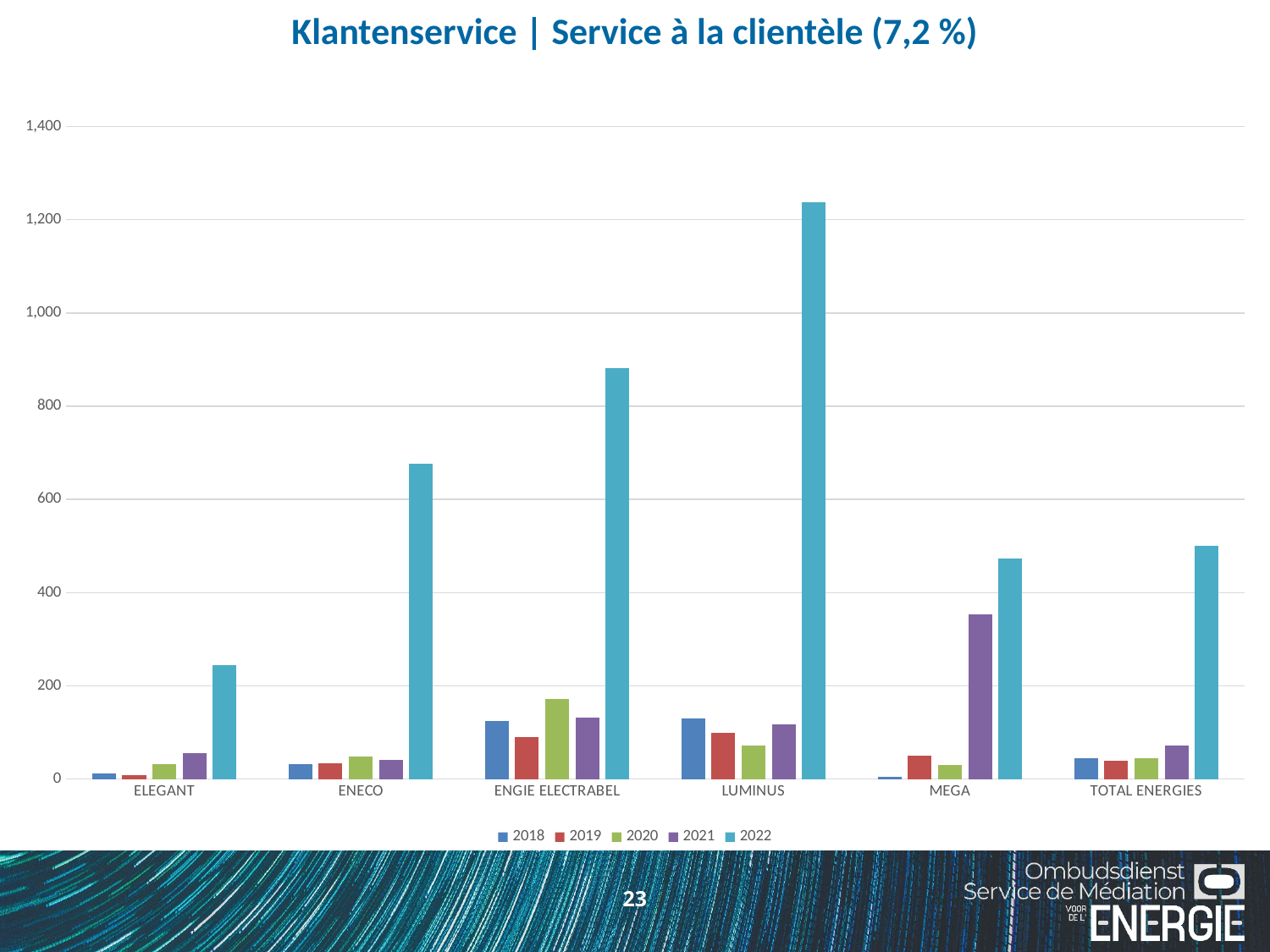
Is the 2022 value for ENGIE ELECTRABEL greater or less than 800? greater Which supplier has the lowest 2022 bar? ELEGANT For MEGA, which year has the highest bar? 2022 Which is larger, the 2021 value for MEGA or the 2021 value for ENGIE ELECTRABEL? MEGA What is the title of the chart? Klantenservice | Service à la clientèle (7,2 %) Is the 2022 value for ENECO greater or less than 600? greater How many supplier categories are shown on the x axis? 6 Is the 2022 value for ELEGANT greater or less than 200? greater How many series does the legend list? 5 Which supplier has the highest 2022 bar? LUMINUS What kind of chart is shown on the slide? bar chart